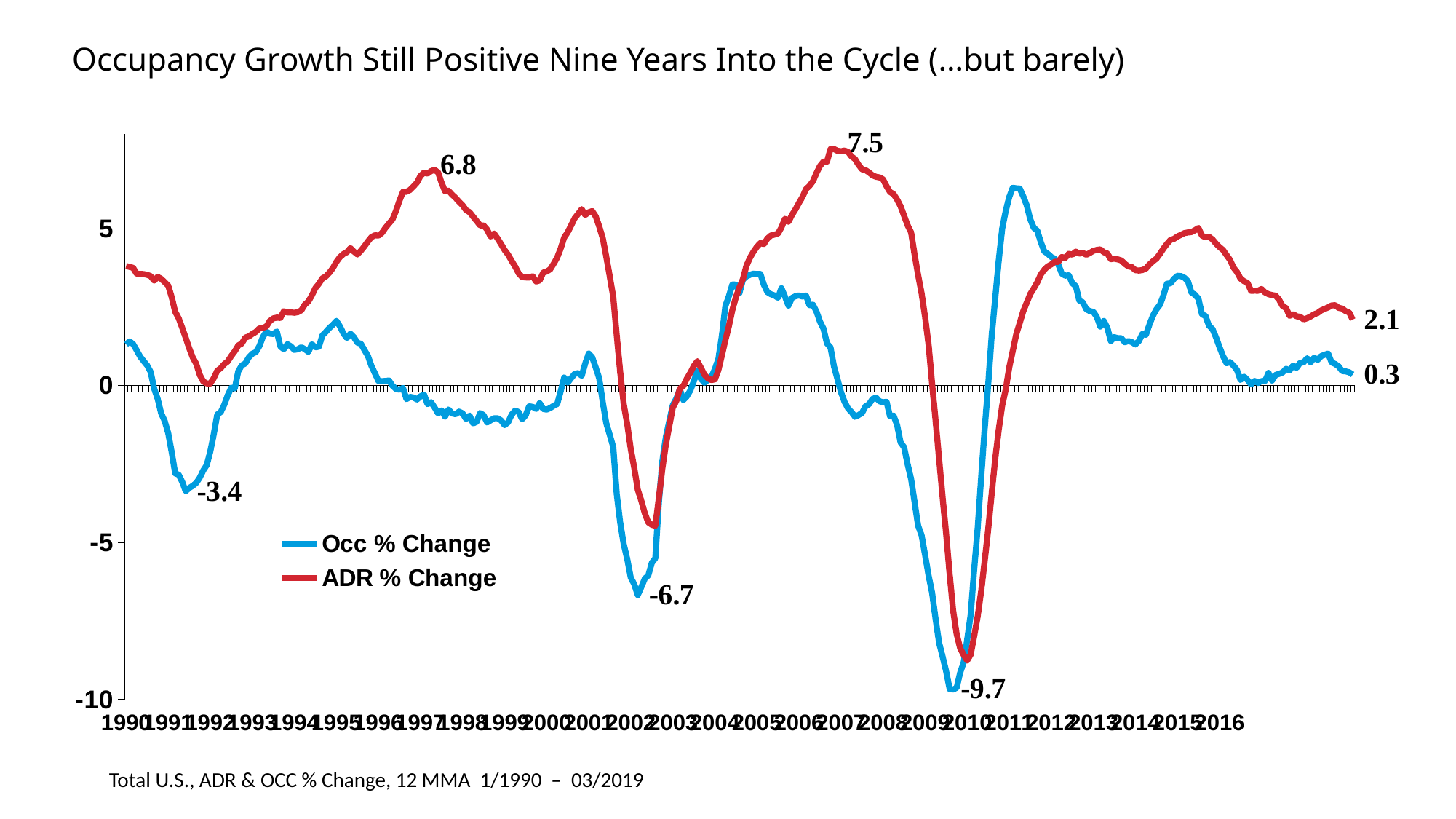
What is the labelled trough value of the Occ % Change series around 1991? -3.4 What is the labelled peak value of the ADR % Change series around 2007? 7.5 What is the difference between the two labelled ADR % Change peaks, 7.5 and 6.8? 0.7 What kind of chart is shown on the slide? line chart What is the final labelled value of the ADR % Change series at the right end of the chart? 2.1 What is the final labelled value of the Occ % Change series at the right end of the chart? 0.3 How many series does the legend list? 2 What colour is the line for the Occ % Change series? blue What is the labelled peak value of the ADR % Change series around 1997? 6.8 Is the Occ % Change value around 2002 (labelled -6.7) greater or less than -5? less What is the labelled lowest value of the Occ % Change series around 2009? -9.7 At the right end of the chart, which series has the larger value, Occ % Change or ADR % Change? ADR % Change